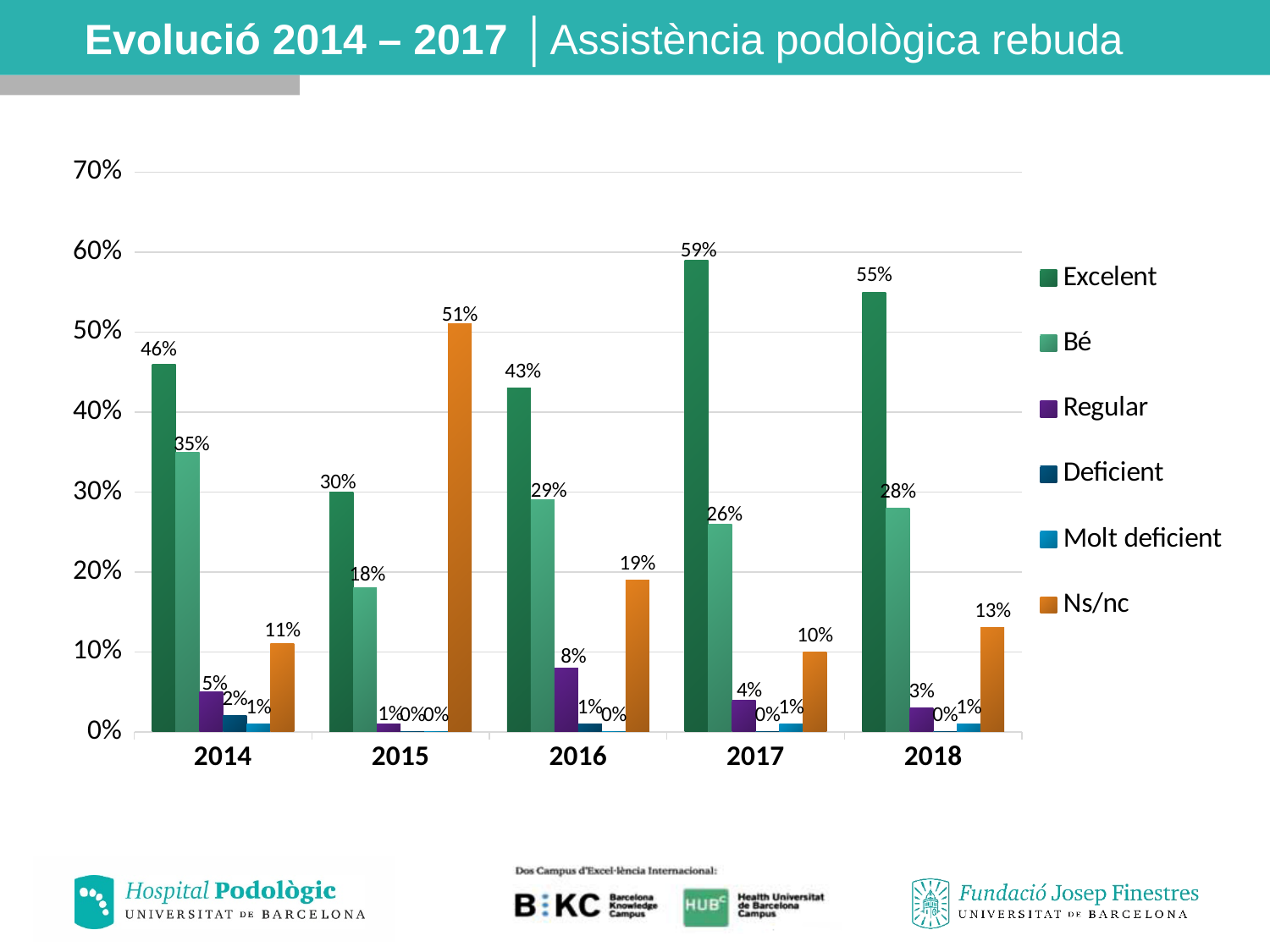
In which year is the Bé value lowest? 2015 How many series does the legend list? 6 What is the value for Regular in 2016? 8% What is the value for Ns/nc in 2015? 51% What is the value for Excelent in 2017? 59% In which year is the Excelent value highest? 2017 What kind of chart is shown on the slide? Bar chart Which is larger in 2015, Excelent or Ns/nc? Ns/nc What is the difference between the Excelent values in 2017 and 2014? 13% How many years are shown on the x axis? 5 Does the Ns/nc value rise or fall from 2015 to 2017? Fall What is the value for Bé in 2014? 35%